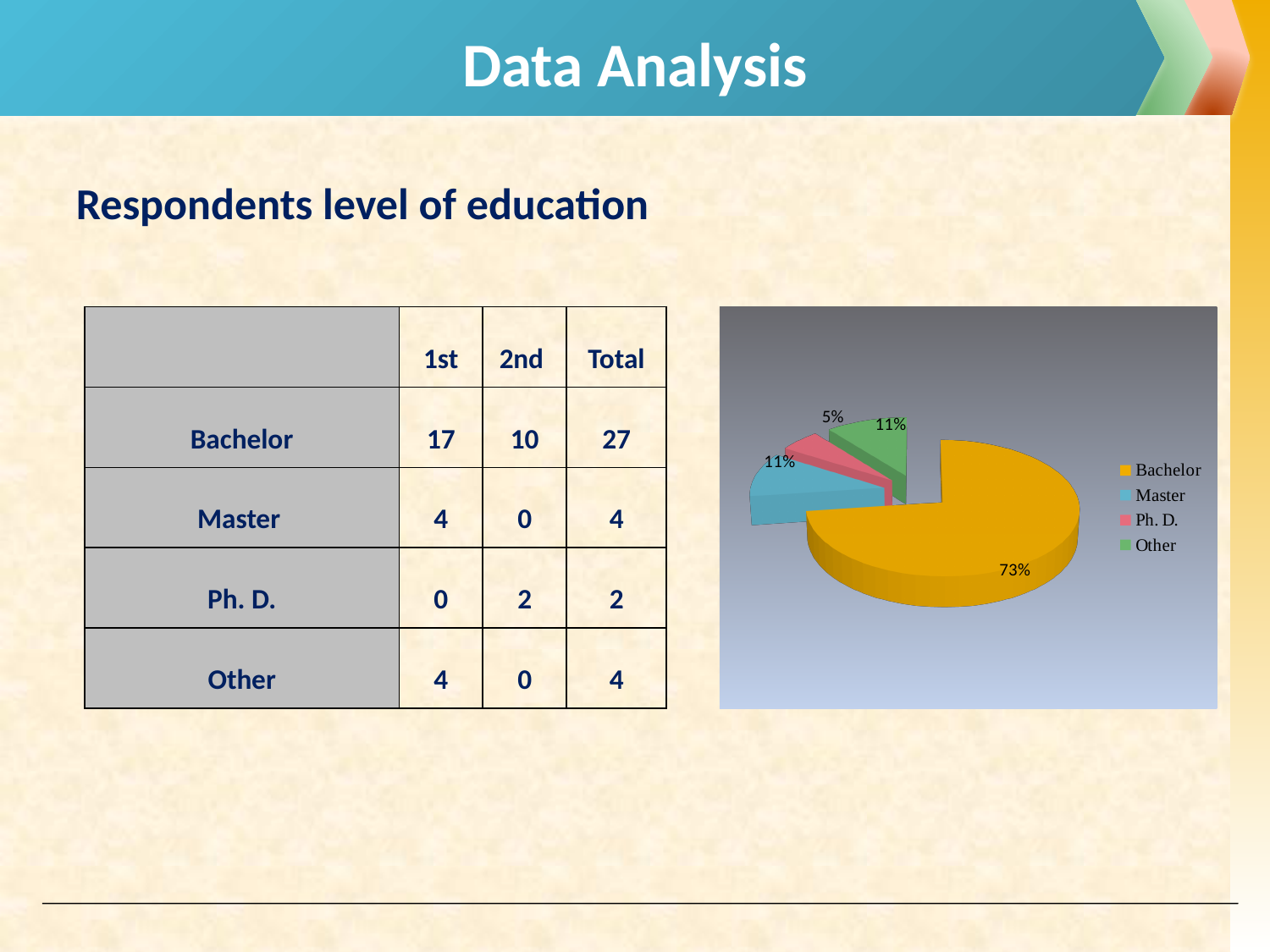
What share of the pie chart does Bachelor represent? 73% How many entries does the pie chart's legend list? 4 How many slices does the pie chart have? 4 What kind of chart is shown on the slide? pie chart What share of the pie chart does Master represent? 11% What is the difference in percentage points between the Bachelor slice and the Ph. D. slice in the pie chart? 68 What share of the pie chart does Other represent? 11% Which category has the smallest slice in the pie chart? Ph. D. In the pie chart, which is larger: the Bachelor slice or the Master slice? Bachelor What colour is the Bachelor slice in the pie chart? yellow Which category has the largest slice in the pie chart? Bachelor